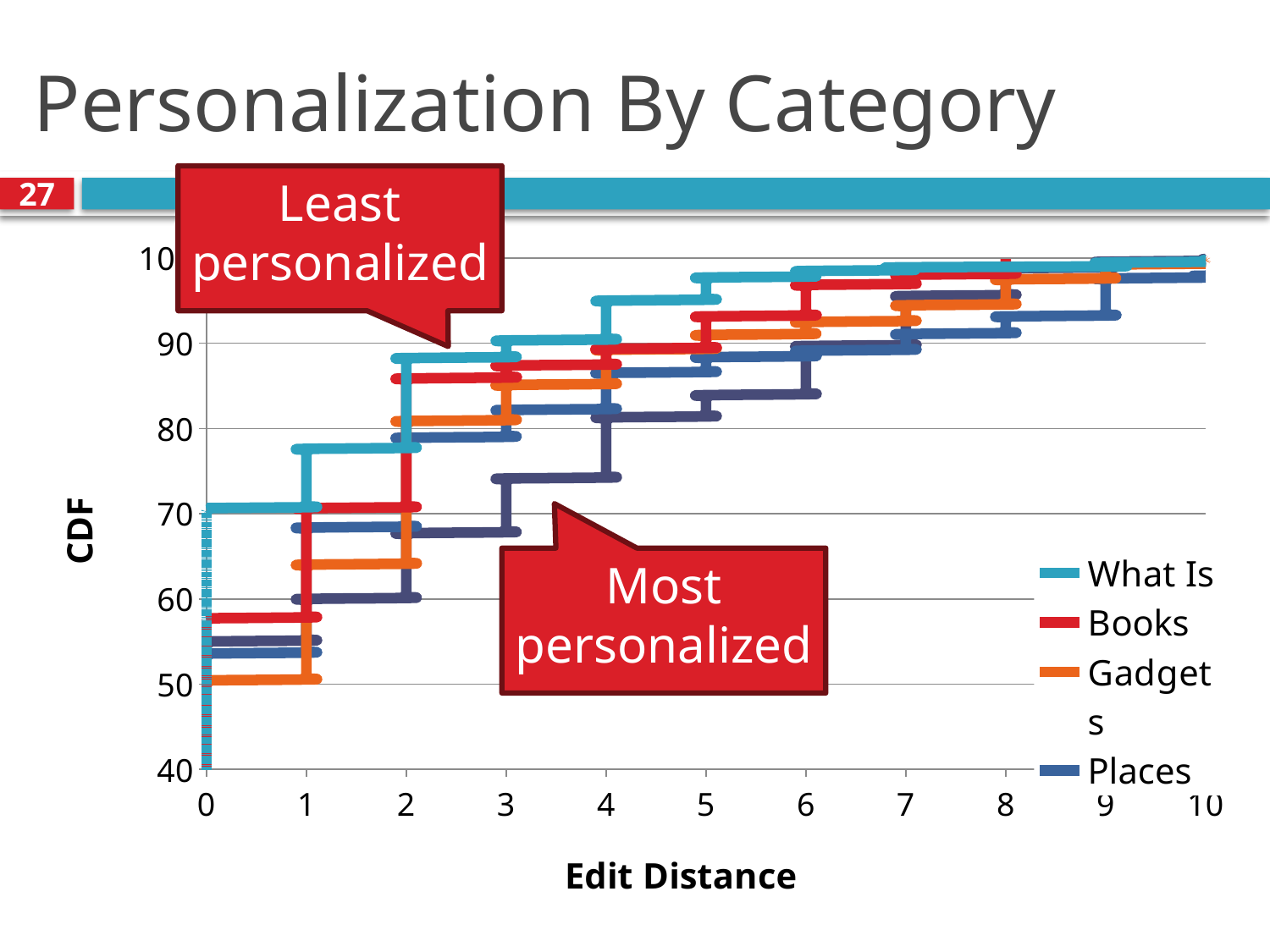
What are the series listed in the legend? What Is, Books, Gadgets, Places Is the value for Places at edit distance 3 greater or less than 70? greater Is the value for What Is at edit distance 2 greater or less than 90? less What is the label of the x axis? Edit Distance Do the CDF values rise or fall as Edit Distance increases? rise Is the value for Places at edit distance 0 greater or less than 60? less What kind of chart is shown on the slide? line chart How many series does the legend list? 4 At edit distance 1, which series has the higher CDF value, What Is or Places? What Is At edit distance 3, which series has the higher CDF value, Books or Places? Books